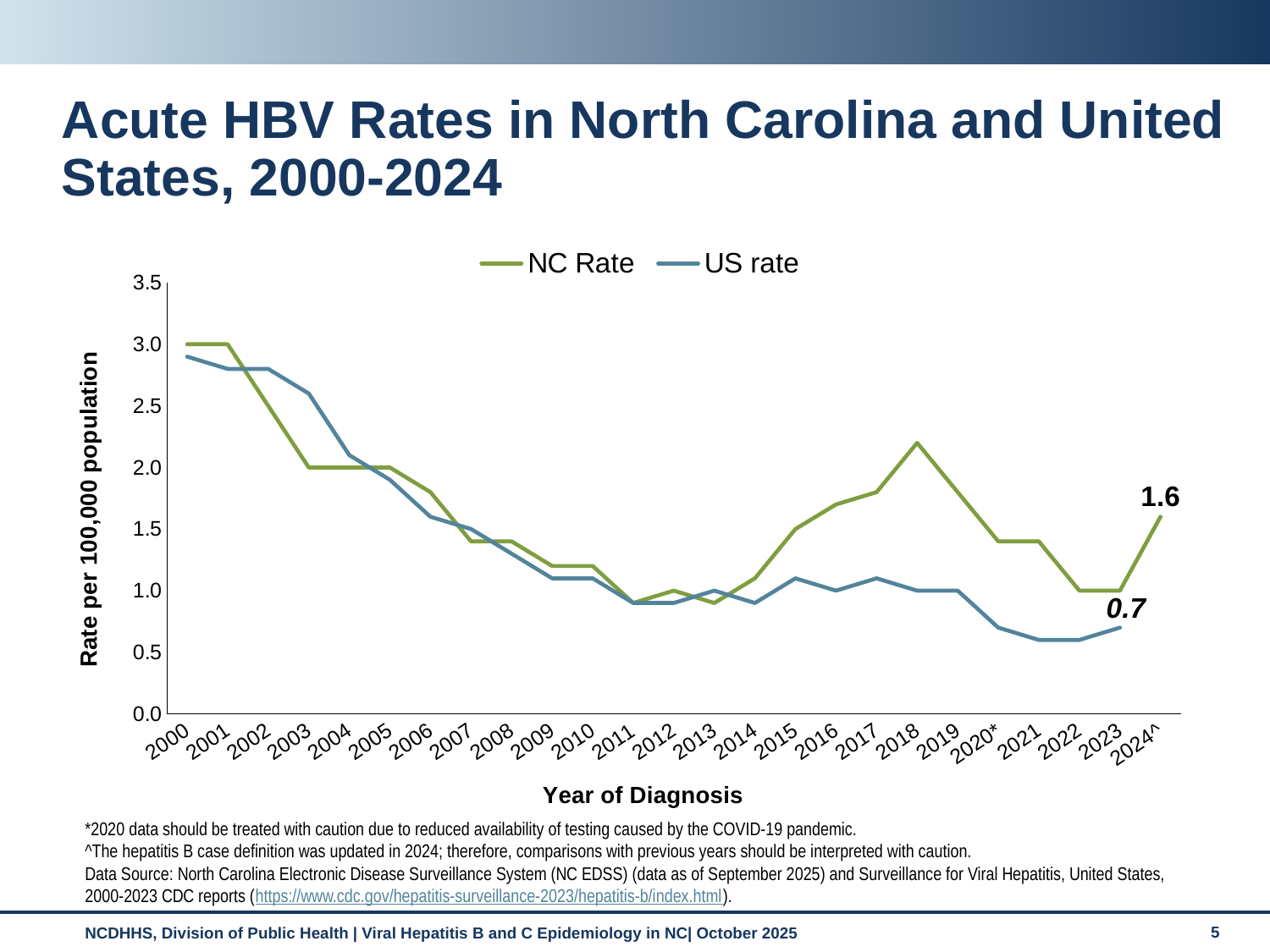
What is the title of the y axis? Rate per 100,000 population How many series does the legend list? 2 Which year has the highest US rate? 2000 What is the NC Rate for 2024^? 1.6 Does the NC Rate rise or fall from 2000 to 2011? Fall What kind of chart is shown on the slide? Line chart In 2018, which is higher, the NC Rate or the US rate? NC Rate What is the US rate for 2023? 0.7 Is the NC Rate for 2018 greater or less than 2.0? greater What is the NC Rate for 2000? 3.0 Is the US rate for 2021 greater or less than 1.0? less How many years are shown on the x axis? 25